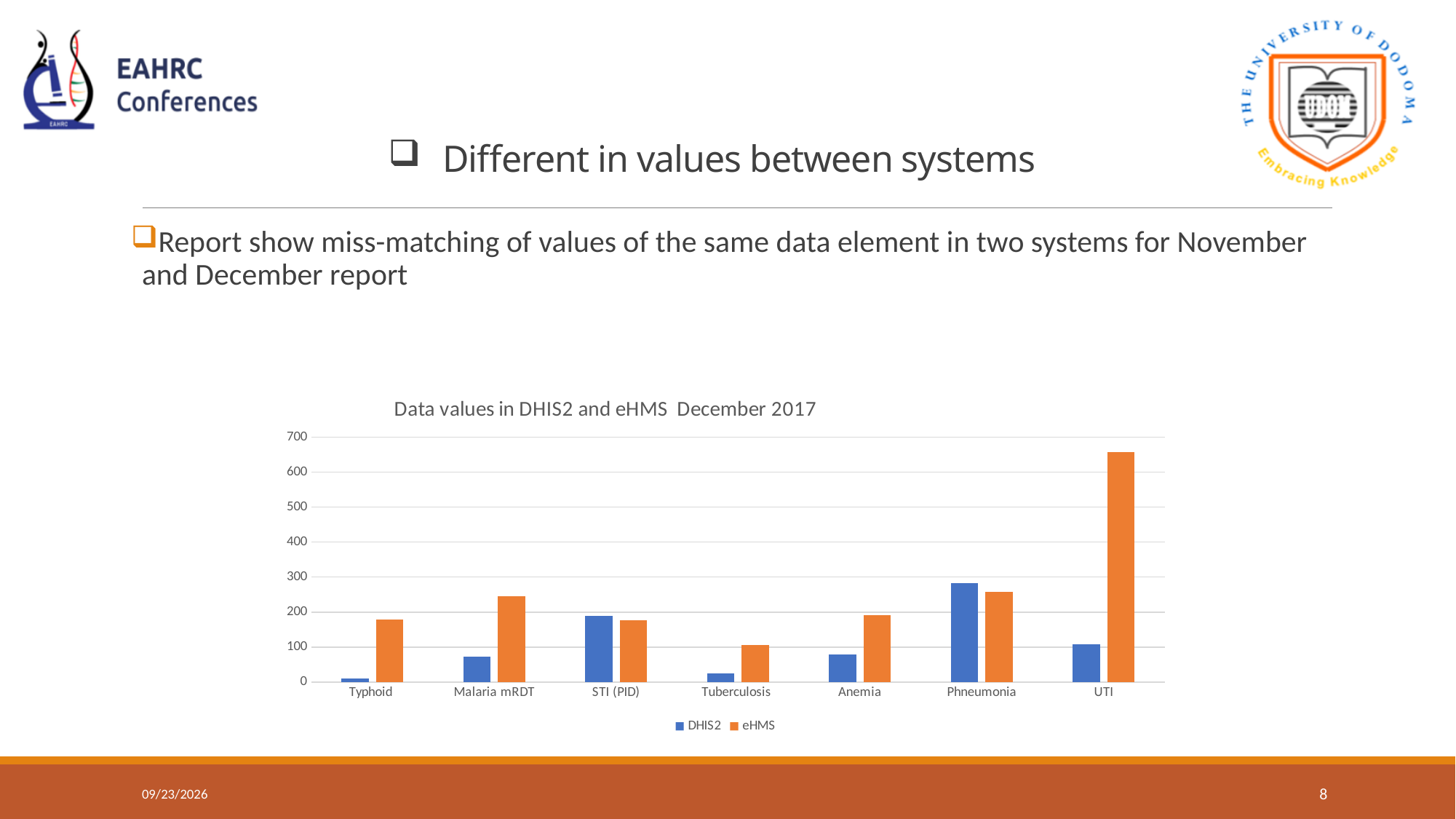
Is the DHIS2 value for Tuberculosis greater or less than 100? less Which category has the highest DHIS2 value? Phneumonia Which category has the highest eHMS value? UTI Which category has the lowest eHMS value? Tuberculosis For Phneumonia, which series has the larger value, DHIS2 or eHMS? DHIS2 What is the title of the chart? Data values in DHIS2 and eHMS December 2017 What kind of chart is shown on the slide? bar chart For UTI, which series has the larger value, DHIS2 or eHMS? eHMS How many categories are shown on the x axis of the chart? 7 Is the eHMS value for UTI greater or less than 600? greater How many series does the chart legend list? 2 Which category has the lowest DHIS2 value? Typhoid